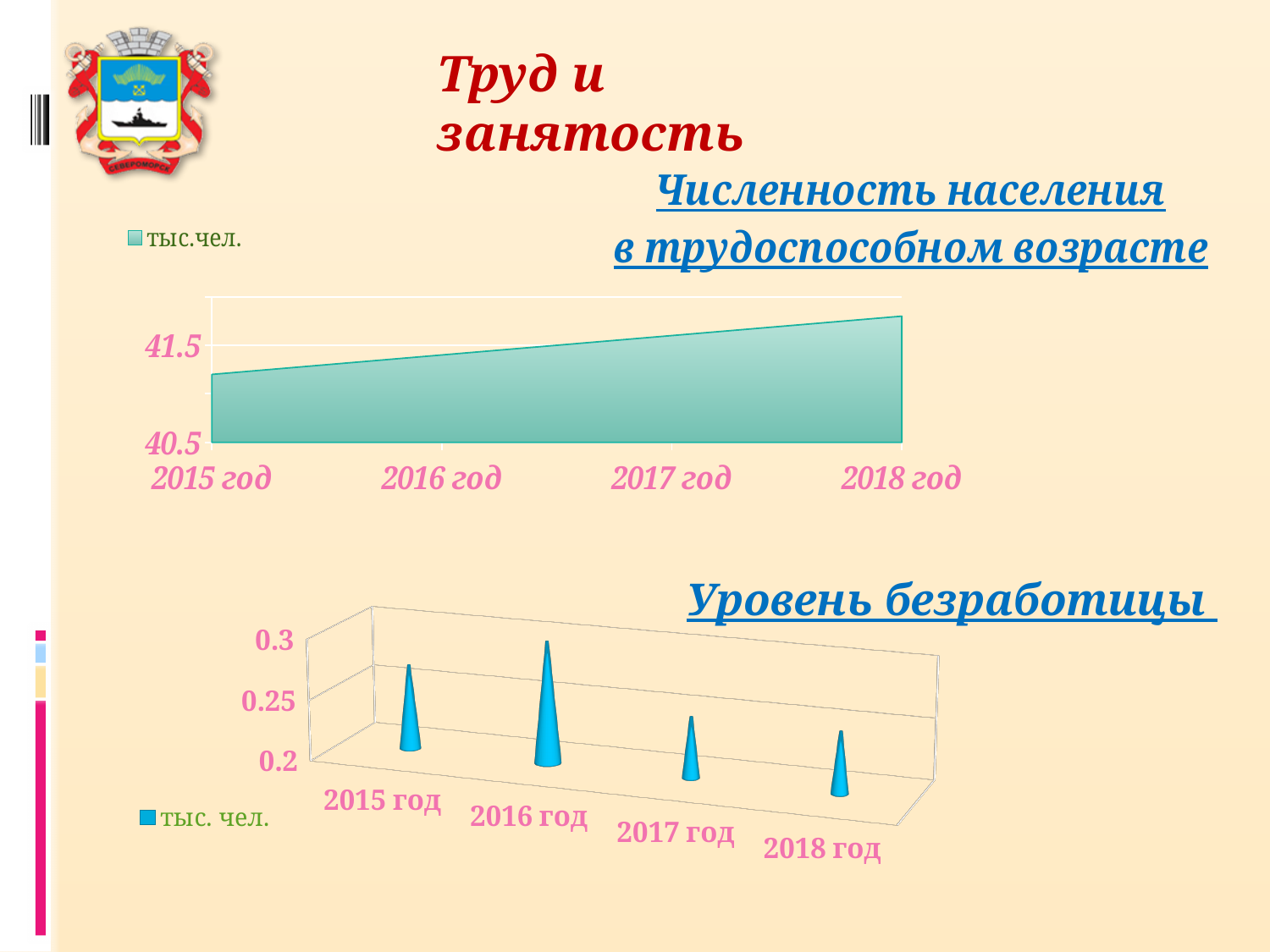
What unit does the legend of the 'Численность населения в трудоспособном возрасте' chart show? тыс.чел. In the 'Численность населения в трудоспособном возрасте' chart, is the value for 2018 год greater or less than 41.5? greater How many years are shown in the 'Уровень безработицы' chart? 4 How many series does the legend of the 'Уровень безработицы' chart list? 1 In the 'Уровень безработицы' chart, which is larger, the value for 2016 год or 2017 год? 2016 год In the 'Уровень безработицы' chart, which year has the highest value? 2016 год In the 'Численность населения в трудоспособном возрасте' chart, is the value for 2015 год greater or less than 41.5? less In the 'Уровень безработицы' chart, is the value for 2016 год greater or less than 0.25? greater What kind of chart is the 'Численность населения в трудоспособном возрасте' chart? area chart How many years are shown on the x axis of the 'Численность населения в трудоспособном возрасте' chart? 4 In the 'Численность населения в трудоспособном возрасте' chart, do the values rise or fall from 2015 год to 2018 год? rise